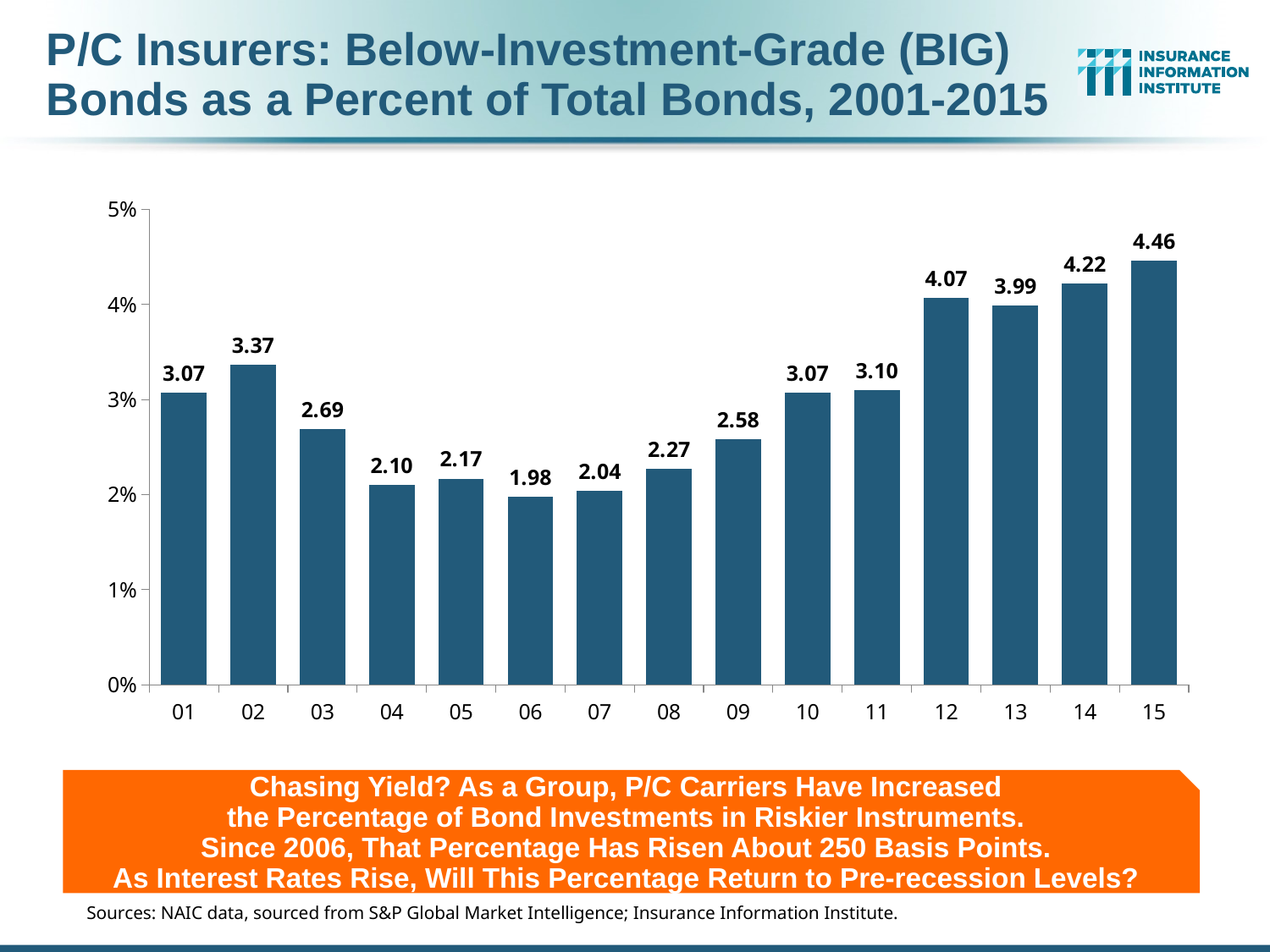
What kind of chart is this? bar chart What is the difference between the values for 15 and 06? 2.48 What is the title of the chart? P/C Insurers: Below-Investment-Grade (BIG) Bonds as a Percent of Total Bonds, 2001-2015 What is the value for 2012 (labelled 12)? 4.07 Which year has the highest value? 15 Which is larger, the value for 13 or the value for 14? 14 Is the value for 09 greater or less than 3%? less What is the value for 2002 (labelled 02)? 3.37 Do the values rise or fall from 11 to 12? rise Which year has the lowest value? 06 How many years are shown on the x axis? 15 What is the value for 2006 (labelled 06)? 1.98